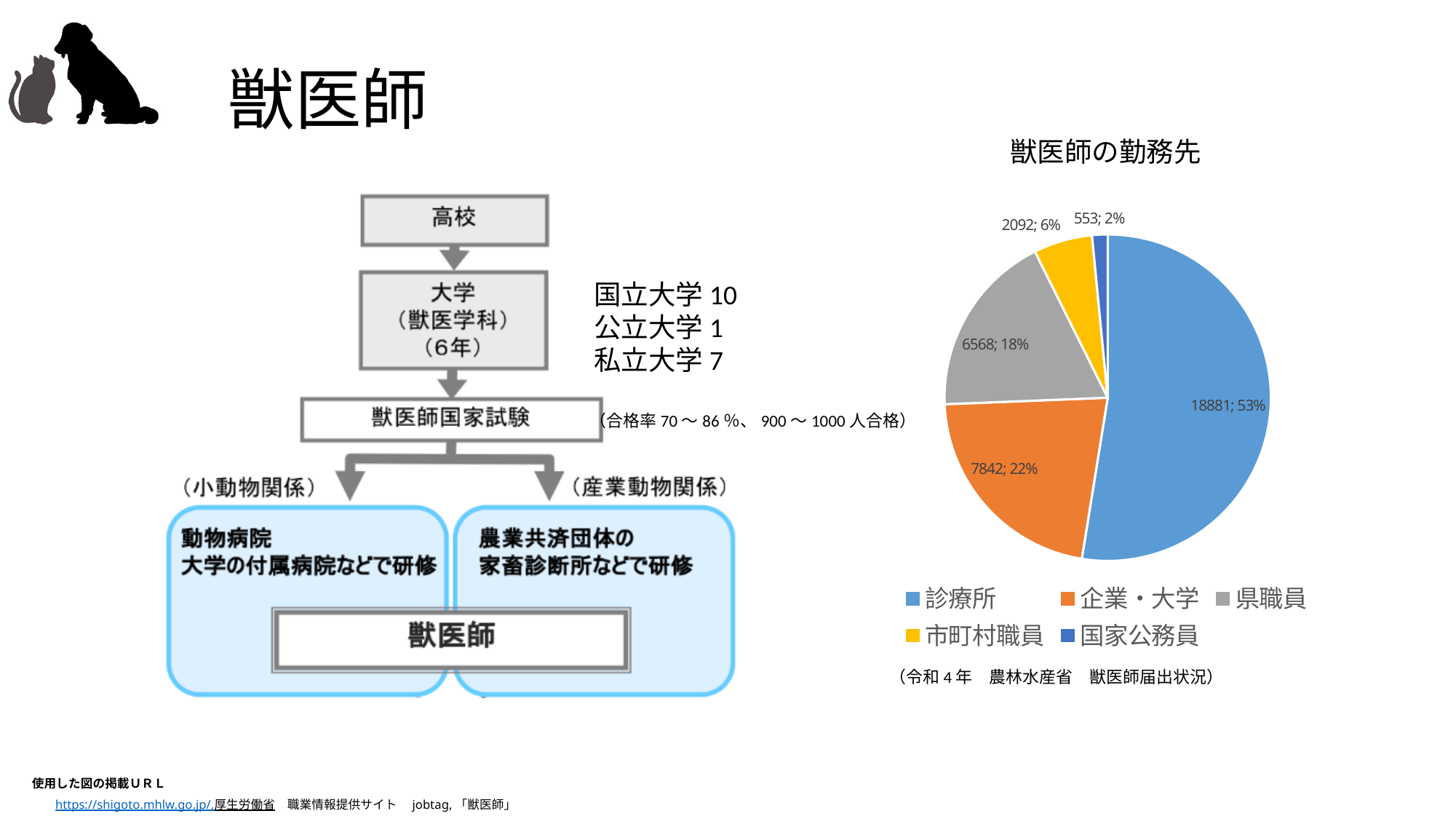
In the 獣医師の勤務先 pie chart, what is the value for 診療所? 18881 In the 獣医師の勤務先 pie chart, what is the value for 国家公務員? 553 In the 獣医師の勤務先 pie chart, what is the difference between the values for 企業・大学 and 県職員? 1274 In the 獣医師の勤務先 pie chart, what share of the pie does 市町村職員 represent? 6% In the 獣医師の勤務先 pie chart, what share of the pie does 診療所 represent? 53% What kind of chart is shown under the title 獣医師の勤務先? Pie chart In the 獣医師の勤務先 pie chart, which category has the largest slice? 診療所 How many categories does the legend of the 獣医師の勤務先 pie chart list? 5 In the 獣医師の勤務先 pie chart, what is the value for 県職員? 6568 In the 獣医師の勤務先 pie chart, which is larger, 県職員 or 市町村職員? 県職員 In the 獣医師の勤務先 pie chart, which category has the smallest slice? 国家公務員 In the 獣医師の勤務先 pie chart, what is the value for 企業・大学? 7842